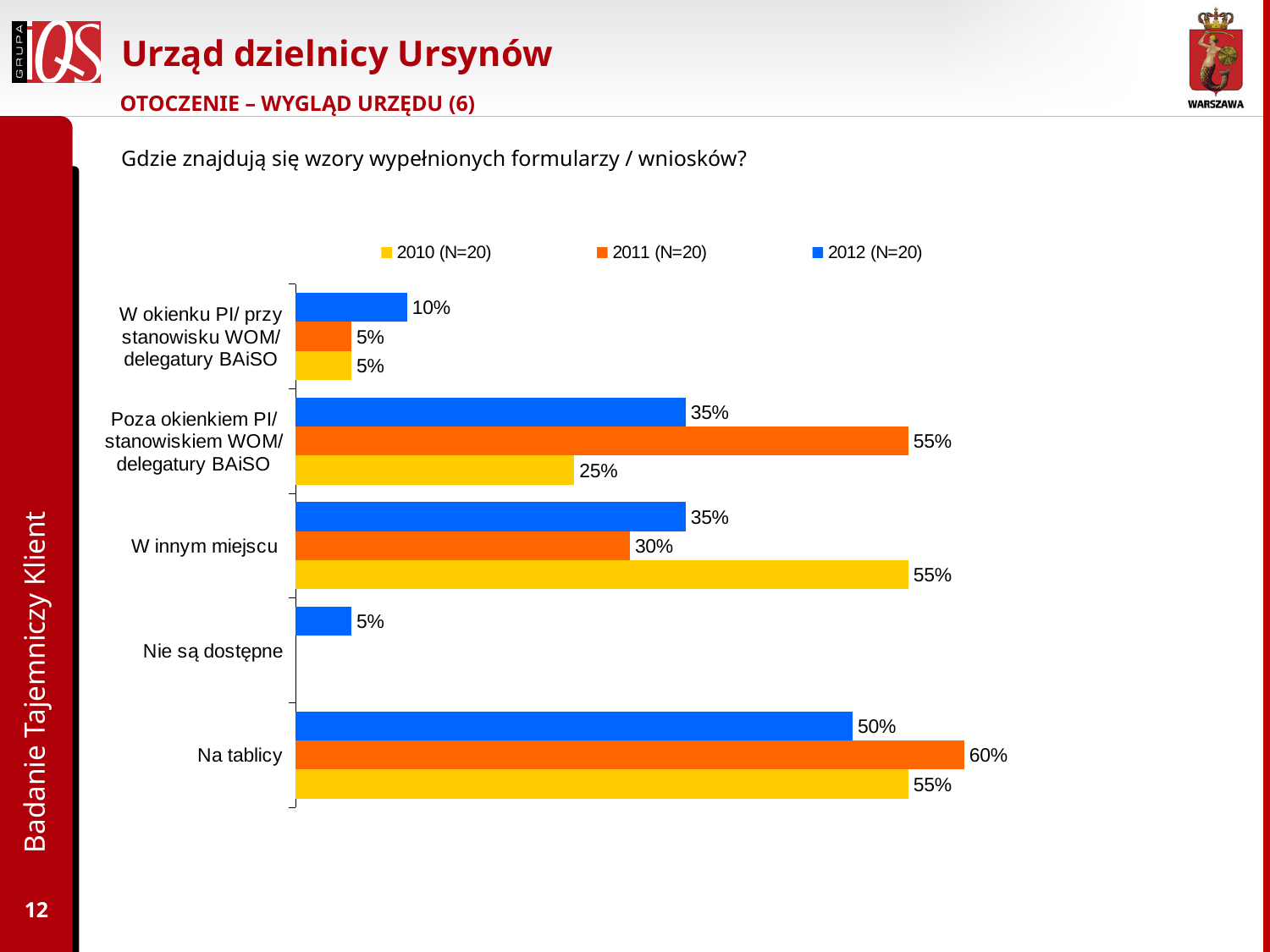
What is the value for 'Nie są dostępne' in 2012 (N=20)? 5% What is the value for 'Na tablicy' in 2011 (N=20)? 60% How many categories are shown on the chart? 5 What is the difference between the 2011 (N=20) and 2010 (N=20) values for 'Poza okienkiem PI/ stanowiskiem WOM/ delegatury BAiSO'? 30% What is the value for 'W innym miejscu' in 2010 (N=20)? 55% What kind of chart is shown on the slide? bar chart For 'W innym miejscu', which is larger: the 2010 (N=20) value or the 2011 (N=20) value? 2010 (N=20) What is the value for 'Poza okienkiem PI/ stanowiskiem WOM/ delegatury BAiSO' in 2012 (N=20)? 35% Which colour represents the 2012 (N=20) series in the legend? blue Which category has the lowest value for the 2011 (N=20) series among those with a bar shown? W okienku PI/ przy stanowisku WOM/ delegatury BAiSO Which category has the highest value for the 2012 (N=20) series? Na tablicy How many series does the legend list? 3